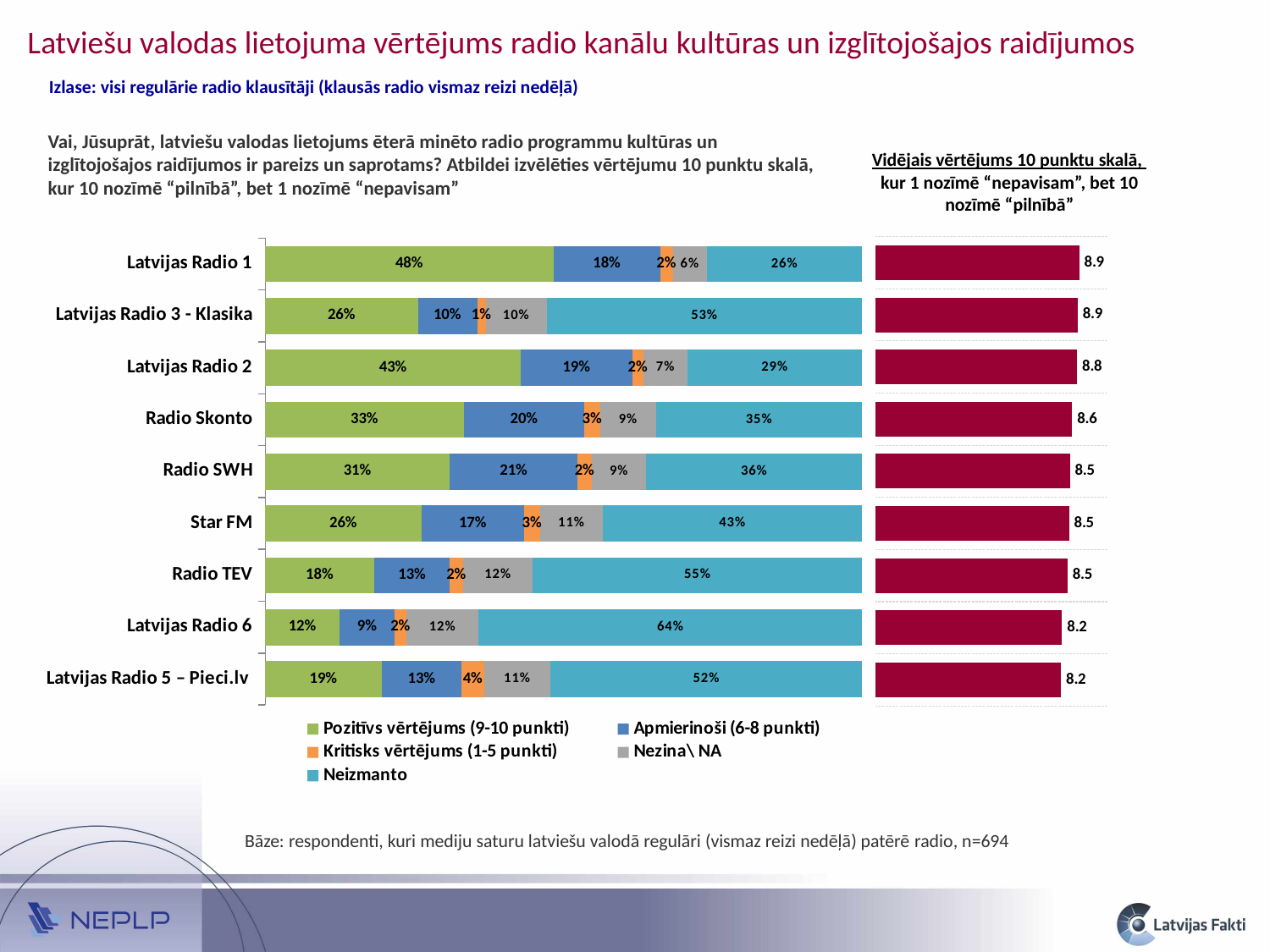
In the stacked bar chart, what is the total of all segments for Latvijas Radio 1 (48%, 18%, 2%, 6%, 26%)? 100% In the stacked bar chart, which radio station has the lowest Pozitīvs vērtējums (9-10 punkti) share? Latvijas Radio 6 How many radio stations are listed in the stacked bar chart? 9 In the right-hand chart of average ratings, what is the difference between the average rating of Latvijas Radio 1 and Latvijas Radio 5 – Pieci.lv? 0.7 How many series does the legend of the stacked bar chart list? 5 In the stacked bar chart, what is the Neizmanto share for Latvijas Radio 6? 64% What kind of chart is the left chart showing the rating shares by radio station? Stacked bar chart In the stacked bar chart, how many percentage points higher is the Pozitīvs vērtējums share for Latvijas Radio 2 than for Radio Skonto? 10 percentage points In the right-hand chart of average ratings (Vidējais vērtējums 10 punktu skalā), what is the average rating for Radio Skonto? 8.6 In the stacked bar chart, which has the larger Neizmanto share: Radio TEV or Latvijas Radio 3 - Klasika? Radio TEV In the stacked bar chart, which radio station has the highest Pozitīvs vērtējums (9-10 punkti) share? Latvijas Radio 1 In the stacked bar chart, what share of respondents gave Latvijas Radio 1 a positive rating (Pozitīvs vērtējums, 9-10 punkti)? 48%